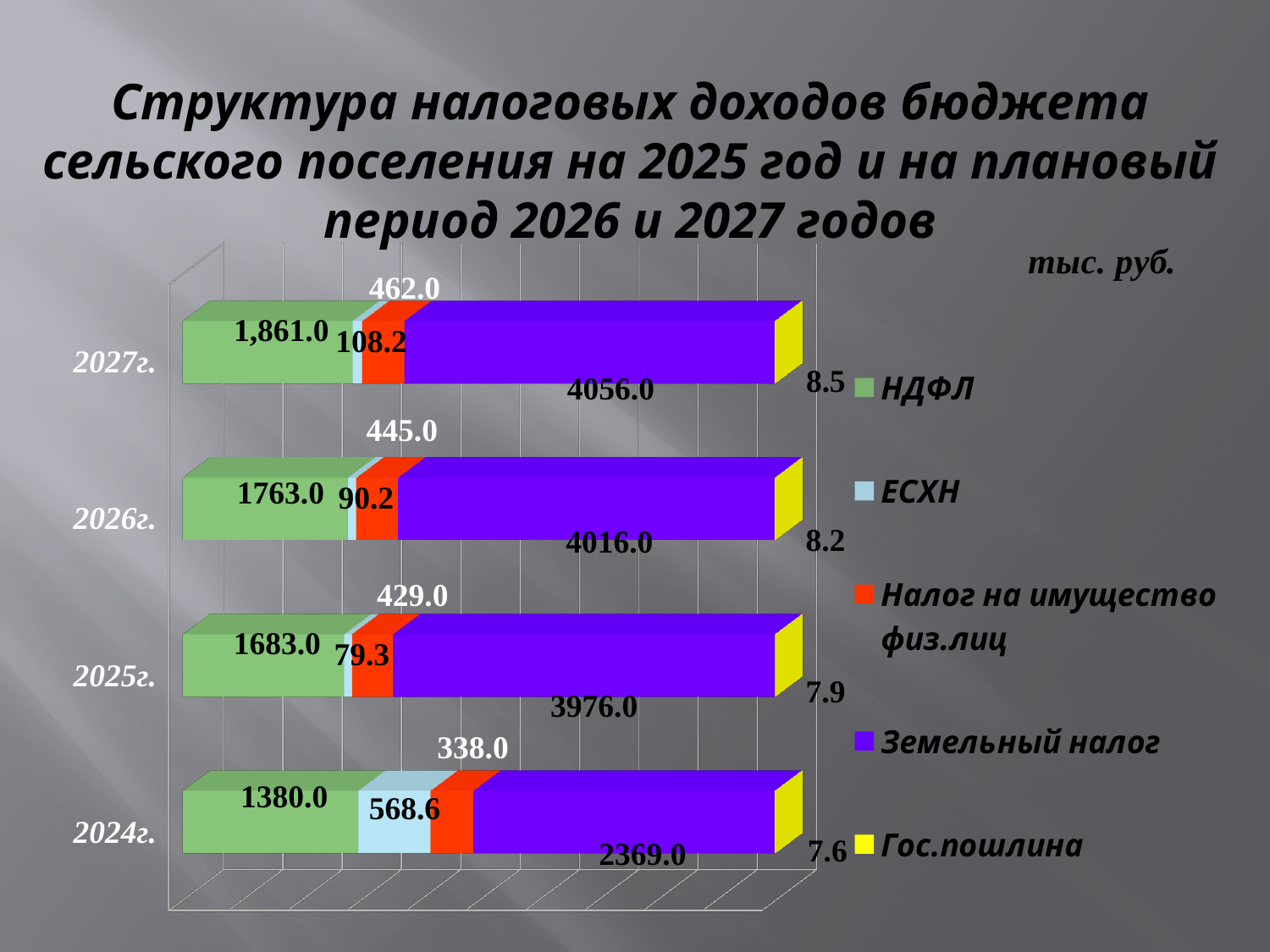
What is the value of НДФЛ for 2024г.? 1380.0 In which year is НДФЛ the highest? 2027г. Which is larger: ЕСХН in 2024г. or ЕСХН in 2025г.? 2024г. How many years (categories) are shown on the chart? 4 In which year is Земельный налог the lowest? 2024г. What is the total of the stacked bar for 2024г.? 4663.2 How many series does the legend list? 5 What type of chart is shown on the slide? Stacked bar chart What is the difference between Земельный налог in 2027г. and in 2026г.? 40.0 What is the value of ЕСХН for 2026г.? 90.2 What is the value of Земельный налог for 2027г.? 4056.0 What is the value of Гос.пошлина for 2025г.? 7.9